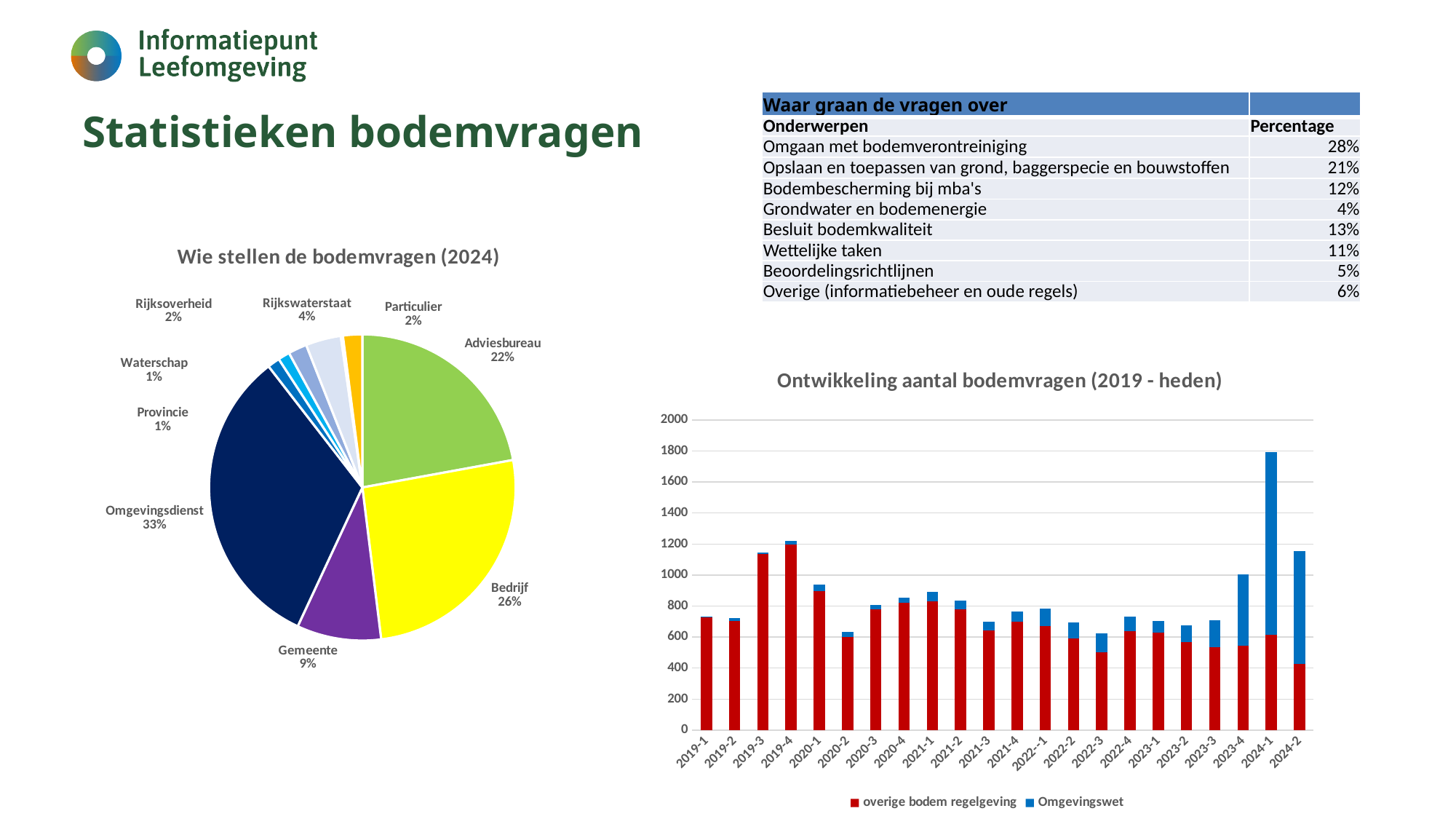
In the pie chart 'Wie stellen de bodemvragen (2024)', which category has the largest share? Omgevingsdienst How many categories are shown in the pie chart 'Wie stellen de bodemvragen (2024)'? 9 In the pie chart 'Wie stellen de bodemvragen (2024)', what share of the questions comes from Omgevingsdienst? 33% What kind of chart is 'Ontwikkeling aantal bodemvragen (2019 - heden)'? Stacked bar chart In the pie chart 'Wie stellen de bodemvragen (2024)', what share of the questions comes from Adviesbureau? 22% What kind of chart is 'Wie stellen de bodemvragen (2024)'? Pie chart In the pie chart 'Wie stellen de bodemvragen (2024)', what is the difference in percentage points between Omgevingsdienst and Bedrijf? 7 percentage points In the chart 'Ontwikkeling aantal bodemvragen (2019 - heden)', is the total value for 2020-2 greater or less than 800? less How many series does the legend of the chart 'Ontwikkeling aantal bodemvragen (2019 - heden)' list? 2 In the chart 'Ontwikkeling aantal bodemvragen (2019 - heden)', which period has the highest total bar? 2024-1 In the chart 'Ontwikkeling aantal bodemvragen (2019 - heden)', is the total value for 2024-1 greater or less than 1600? greater In the pie chart 'Wie stellen de bodemvragen (2024)', which is larger, the share for Bedrijf or the share for Gemeente? Bedrijf